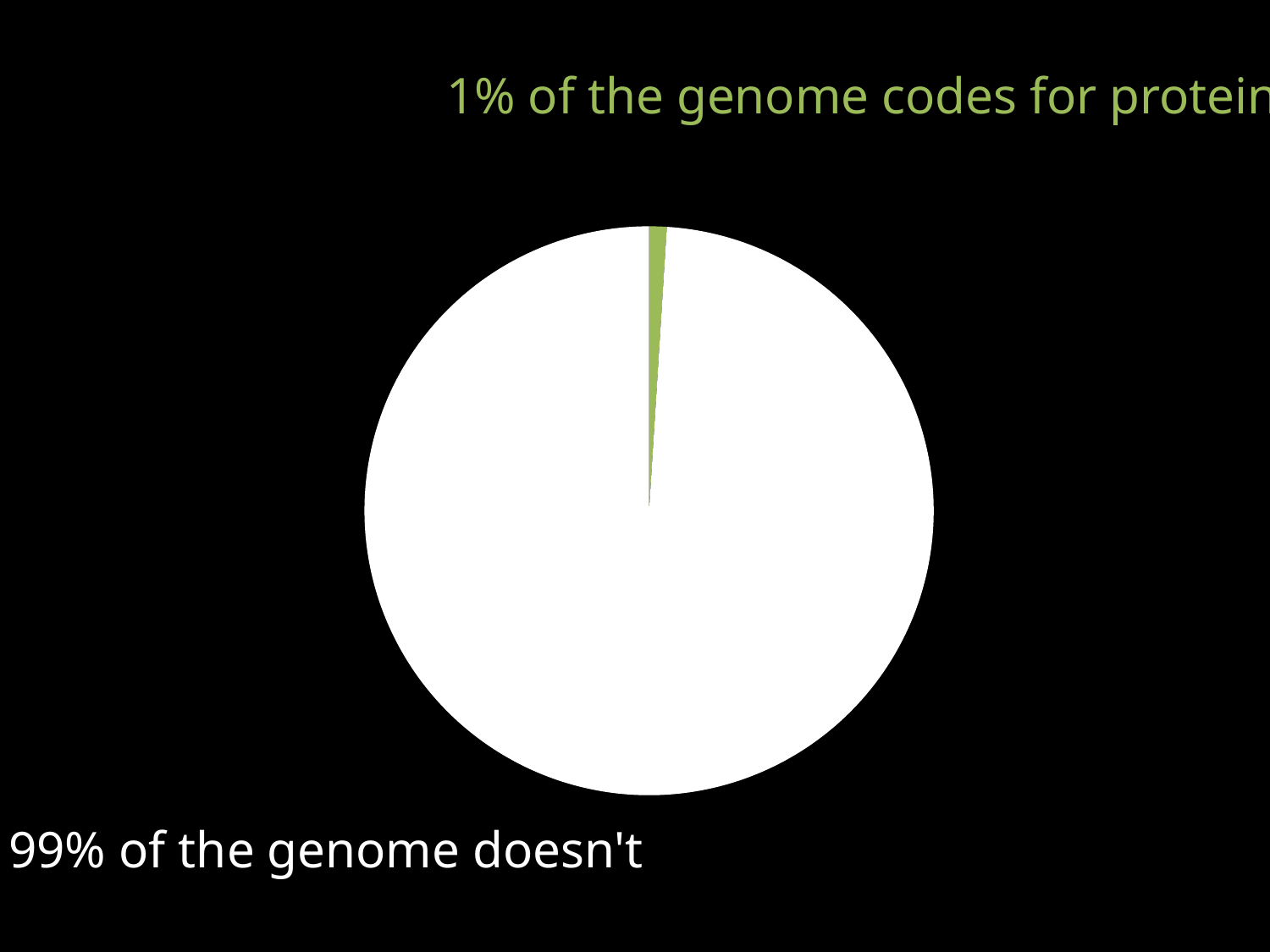
What colour is the slice representing the 99% of the genome that doesn't code for protein? white Which is larger: the share of the genome that codes for protein or the share that doesn't? the share that doesn't What kind of chart is shown on the slide? pie chart How many slices does the pie chart have? 2 What is the difference between the share of the genome that doesn't code for protein and the share that does? 98% What colour is the slice representing the part of the genome that codes for protein? green What share of the genome doesn't code for protein according to the pie chart? 99% Which slice of the pie chart is the largest? 99% of the genome doesn't Which slice of the pie chart is the smallest? 1% of the genome codes for protein What share of the genome codes for protein according to the pie chart? 1%